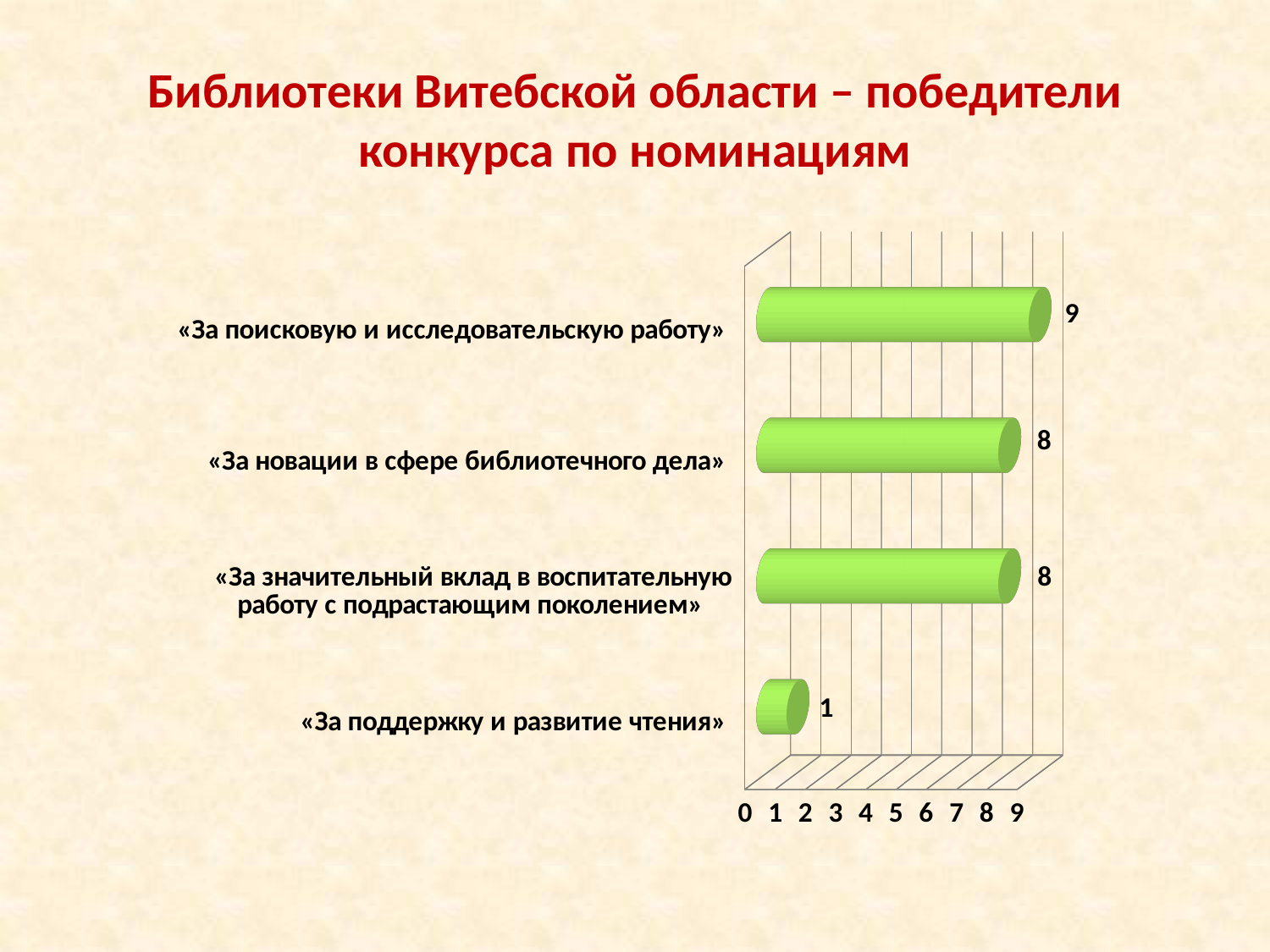
What kind of chart is shown on the slide? Bar chart What is the value for «За поддержку и развитие чтения»? 1 Which is larger: the value for «За новации в сфере библиотечного дела» or the value for «За поддержку и развитие чтения»? «За новации в сфере библиотечного дела» What is the value for «За поисковую и исследовательскую работу»? 9 What is the value for «За значительный вклад в воспитательную работу с подрастающим поколением»? 8 What is the title of the slide containing the chart? Библиотеки Витебской области – победители конкурса по номинациям What is the value for «За новации в сфере библиотечного дела»? 8 Which category has the highest value? «За поисковую и исследовательскую работу» What is the difference between the values for «За поисковую и исследовательскую работу» and «За новации в сфере библиотечного дела»? 1 Which category has the lowest value? «За поддержку и развитие чтения» What is the difference between the values for «За поисковую и исследовательскую работу» and «За поддержку и развитие чтения»? 8 How many categories are shown in the chart? 4